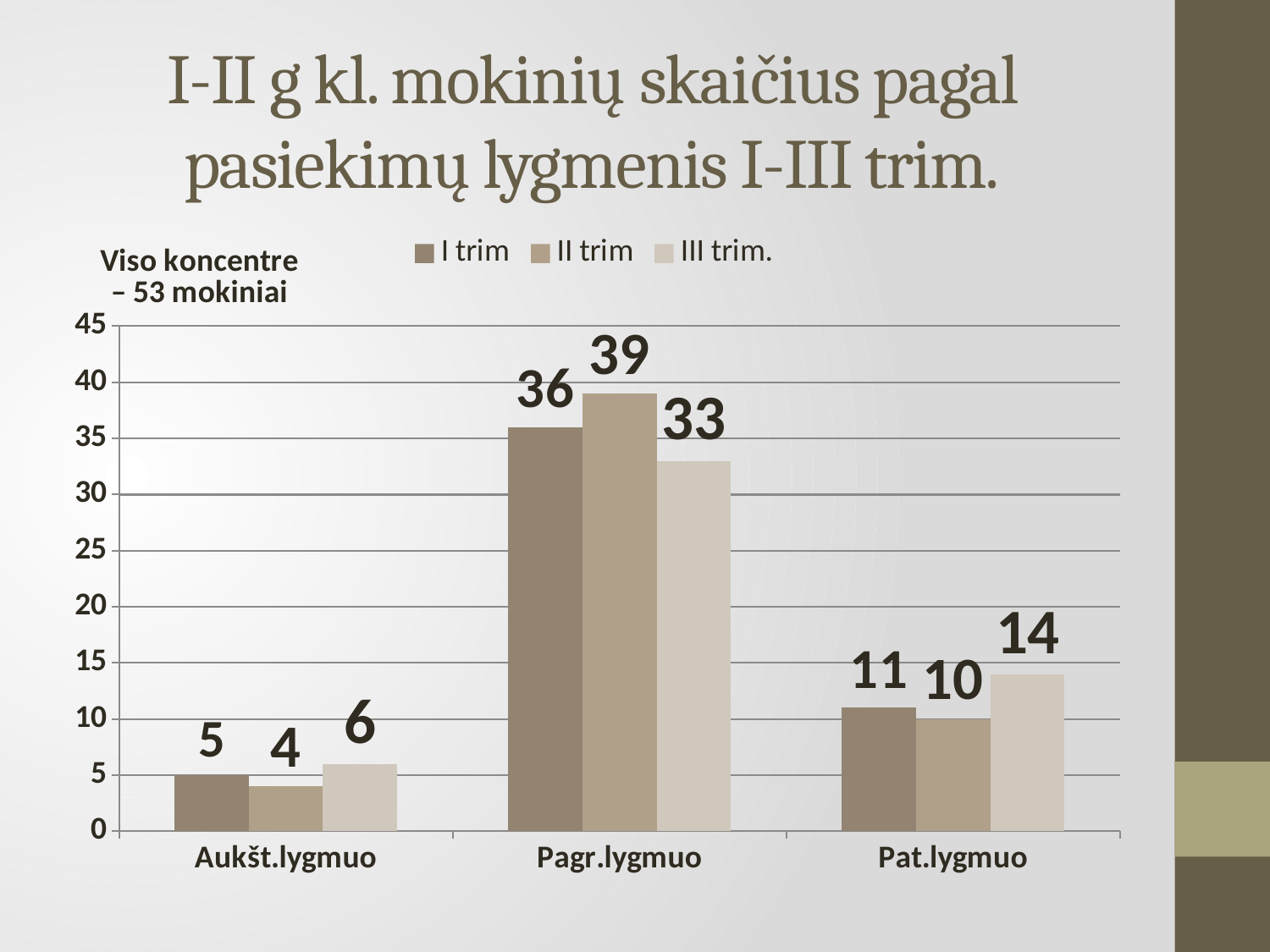
What is the value for I trim in the Pagr.lygmuo category? 36 What is the value for II trim in the Aukšt.lygmuo category? 4 What is the value for III trim. in the Pat.lygmuo category? 14 What is the difference between the II trim and III trim. values in the Pagr.lygmuo category? 6 How many series does the legend list? 3 Which category has the lowest value for III trim.? Aukšt.lygmuo What is the total number of students in the concentre stated on the chart? 53 How many categories are shown on the x axis? 3 Is the value for III trim. in the Pagr.lygmuo category greater or less than 30? greater Which category has the highest value for II trim? Pagr.lygmuo Which is larger in the Pat.lygmuo category: the I trim value or the II trim value? I trim What kind of chart is shown on the slide? bar chart